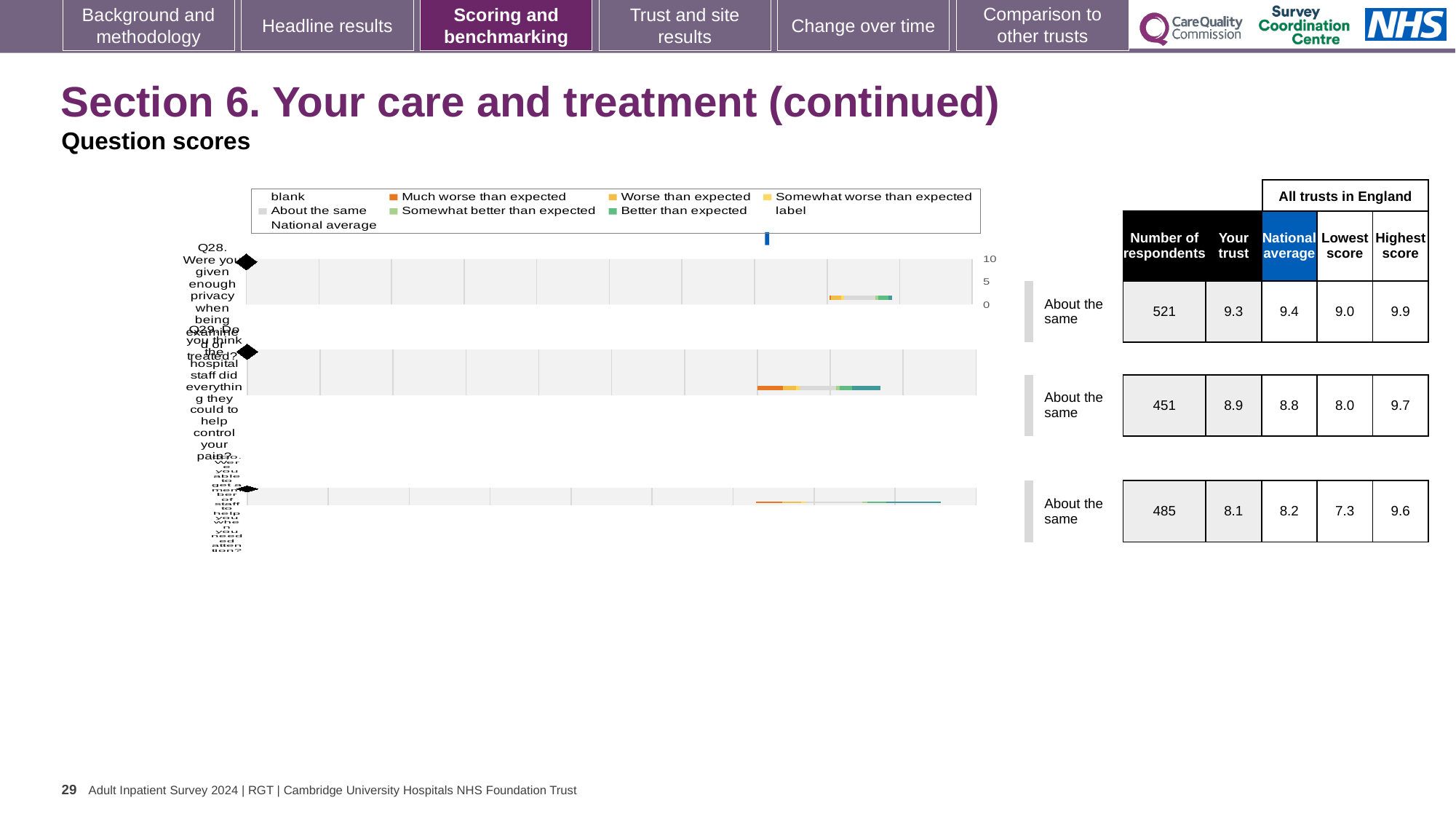
Which question has the lowest number of respondents? Q29 (451) What benchmark category is shown for all three questions on this slide? About the same What is the 'Your trust' score for Q29 (staff did everything to help control your pain)? 8.9 Which question has the highest 'Your trust' score? Q28 (9.3) For Q29, which is larger: the 'Your trust' score or the national average? Your trust (8.9) What is the number of respondents for Q28 (privacy when being examined or treated)? 521 What is the national average score for the third question (Q30)? 8.2 How many questions (rows) are plotted in the question scores chart? 3 For Q28, what is the difference between the national average and the 'Your trust' score? 0.1 What is the lowest score among all trusts in England for the third question (Q30)? 7.3 What kind of chart is used to show the question scores on this slide? bar chart What is the highest score among all trusts in England for Q28? 9.9